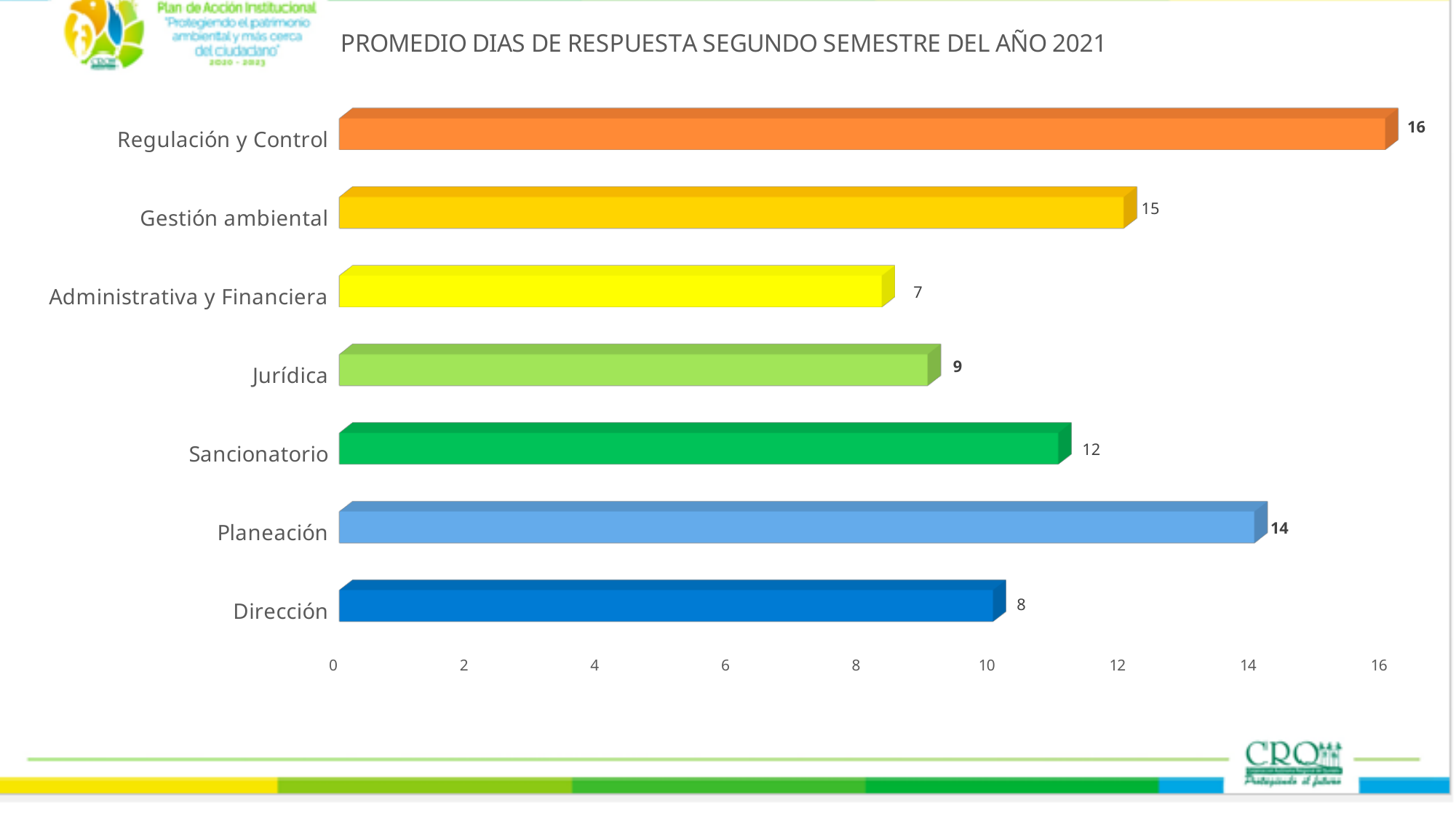
What is the difference between the values for Gestión ambiental and Sancionatorio? 3 What is the value for Jurídica? 9 What kind of chart is shown on the slide? Bar chart Which category has the lowest value? Administrativa y Financiera What is the value for Regulación y Control? 16 What is the title of the chart? PROMEDIO DIAS DE RESPUESTA SEGUNDO SEMESTRE DEL AÑO 2021 Which category has the highest value? Regulación y Control How many categories are shown in the chart? 7 What is the value for Dirección? 8 What colour is the bar for Dirección? Blue Which is larger, the value for Planeación or the value for Sancionatorio? Planeación